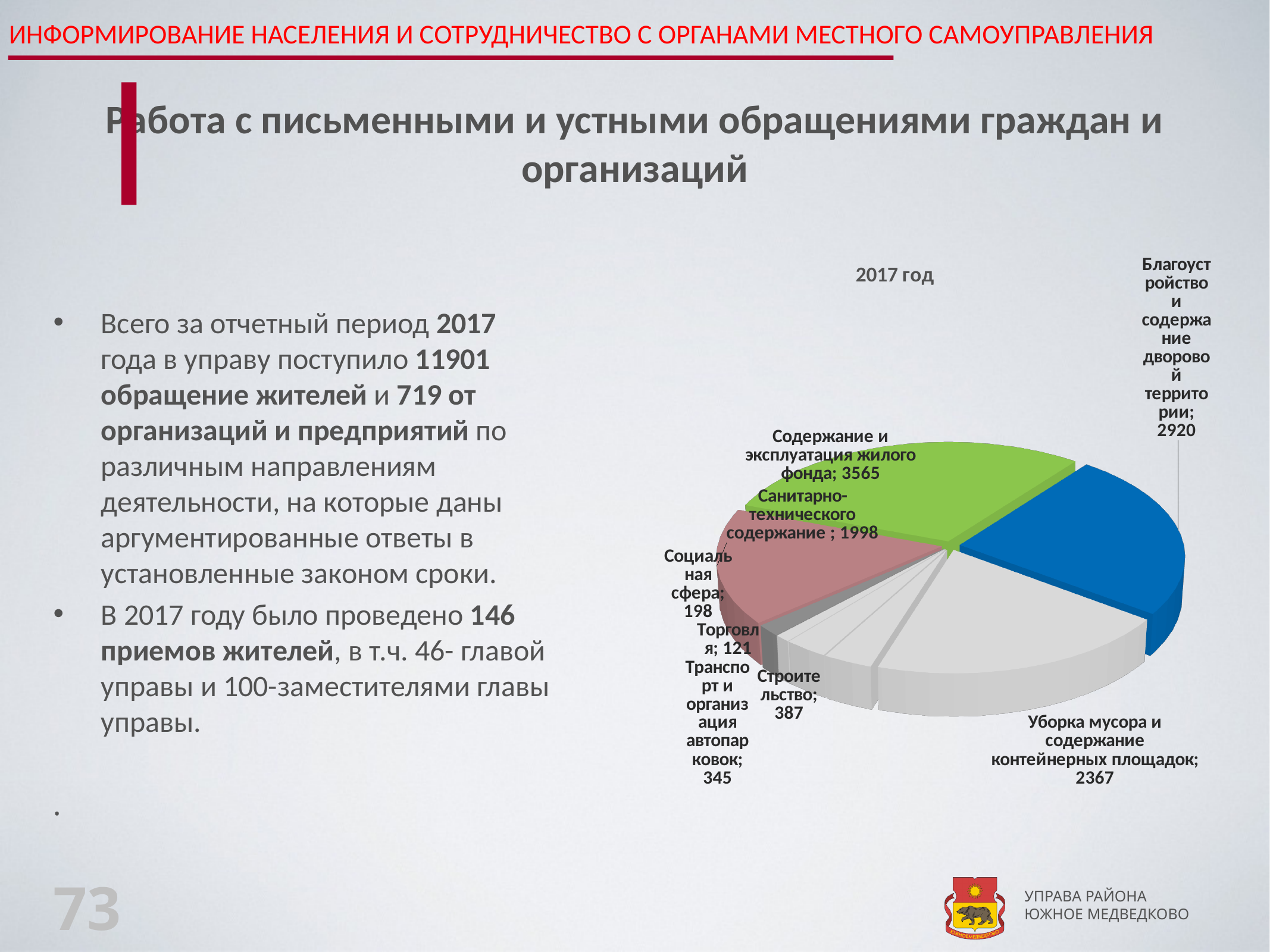
What is the title of the pie chart? 2017 год What is the value for "Транспорт и организация автопарковок"? 345 Which category has the smallest slice in the pie chart? Торговля How many categories (slices) does the pie chart have? 8 What is the value for "Уборка мусора и содержание контейнерных площадок"? 2367 Which category has the largest slice in the pie chart? Содержание и эксплуатация жилого фонда What is the value for "Санитарно-технического содержание"? 1998 What is the value for "Содержание и эксплуатация жилого фонда"? 3565 Which is larger: the value for "Строительство" or the value for "Социальная сфера"? Строительство What kind of chart is shown on the slide? Pie chart What is the difference between the values for "Благоустройство и содержание дворовой территории" and "Уборка мусора и содержание контейнерных площадок"? 553 What is the value for "Благоустройство и содержание дворовой территории"? 2920